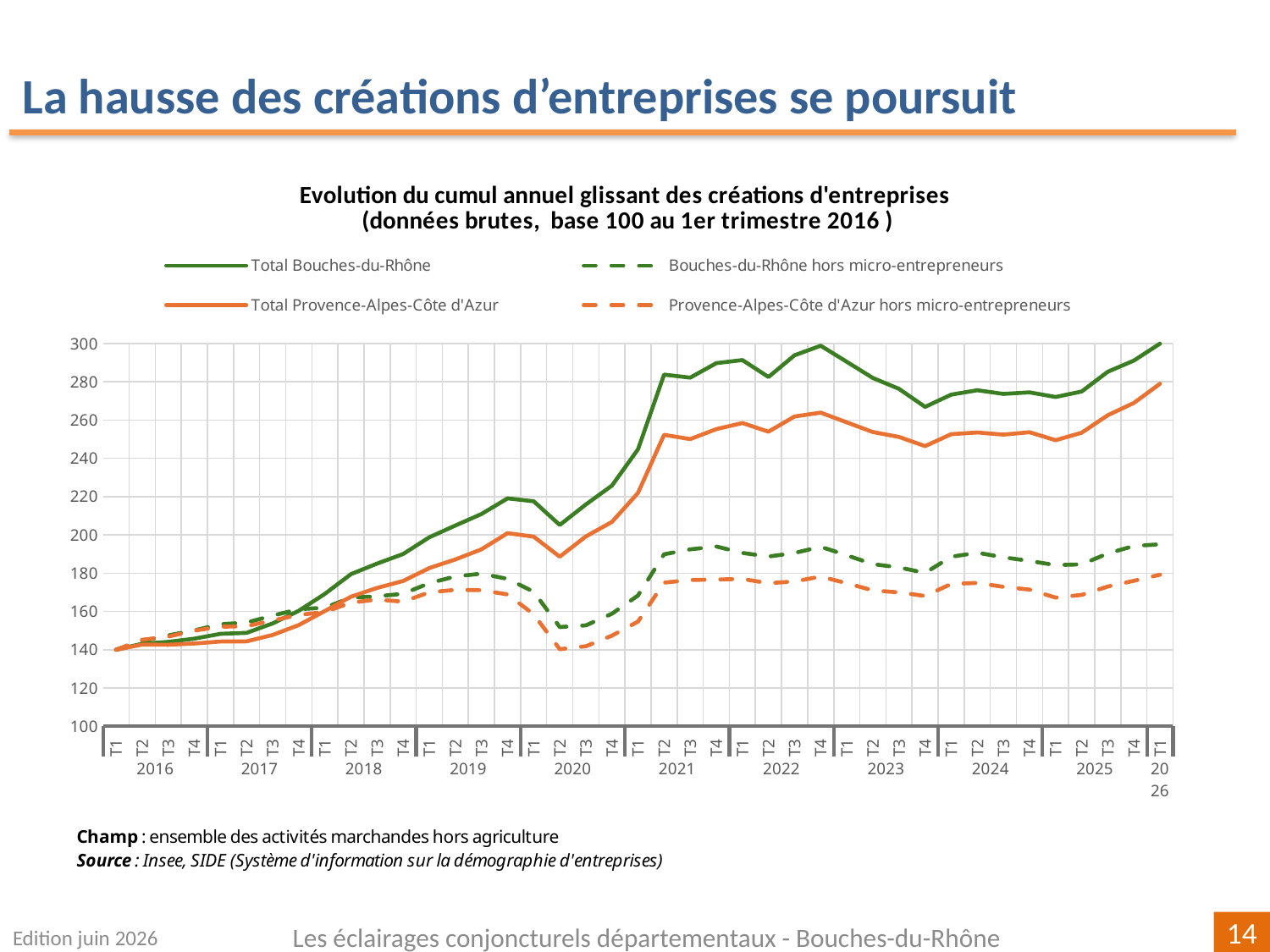
Is the value for Total Provence-Alpes-Côte d'Azur at T1 2026 greater or less than 260? greater At T4 2022, which is higher: Bouches-du-Rhône hors micro-entrepreneurs or Provence-Alpes-Côte d'Azur hors micro-entrepreneurs? Bouches-du-Rhône hors micro-entrepreneurs How many series does the legend list? 4 Is the value for Total Bouches-du-Rhône at T4 2022 greater or less than 280? greater Which series reaches the highest value on the chart? Total Bouches-du-Rhône Is the value for Total Bouches-du-Rhône at T1 2026 greater or less than 280? greater Which series are drawn with dashed lines? Bouches-du-Rhône hors micro-entrepreneurs and Provence-Alpes-Côte d'Azur hors micro-entrepreneurs At T1 2026, which is higher: Total Bouches-du-Rhône or Total Provence-Alpes-Côte d'Azur? Total Bouches-du-Rhône What kind of chart is shown on the slide? line chart What is the title of the chart? Evolution du cumul annuel glissant des créations d'entreprises (données brutes, base 100 au 1er trimestre 2016)